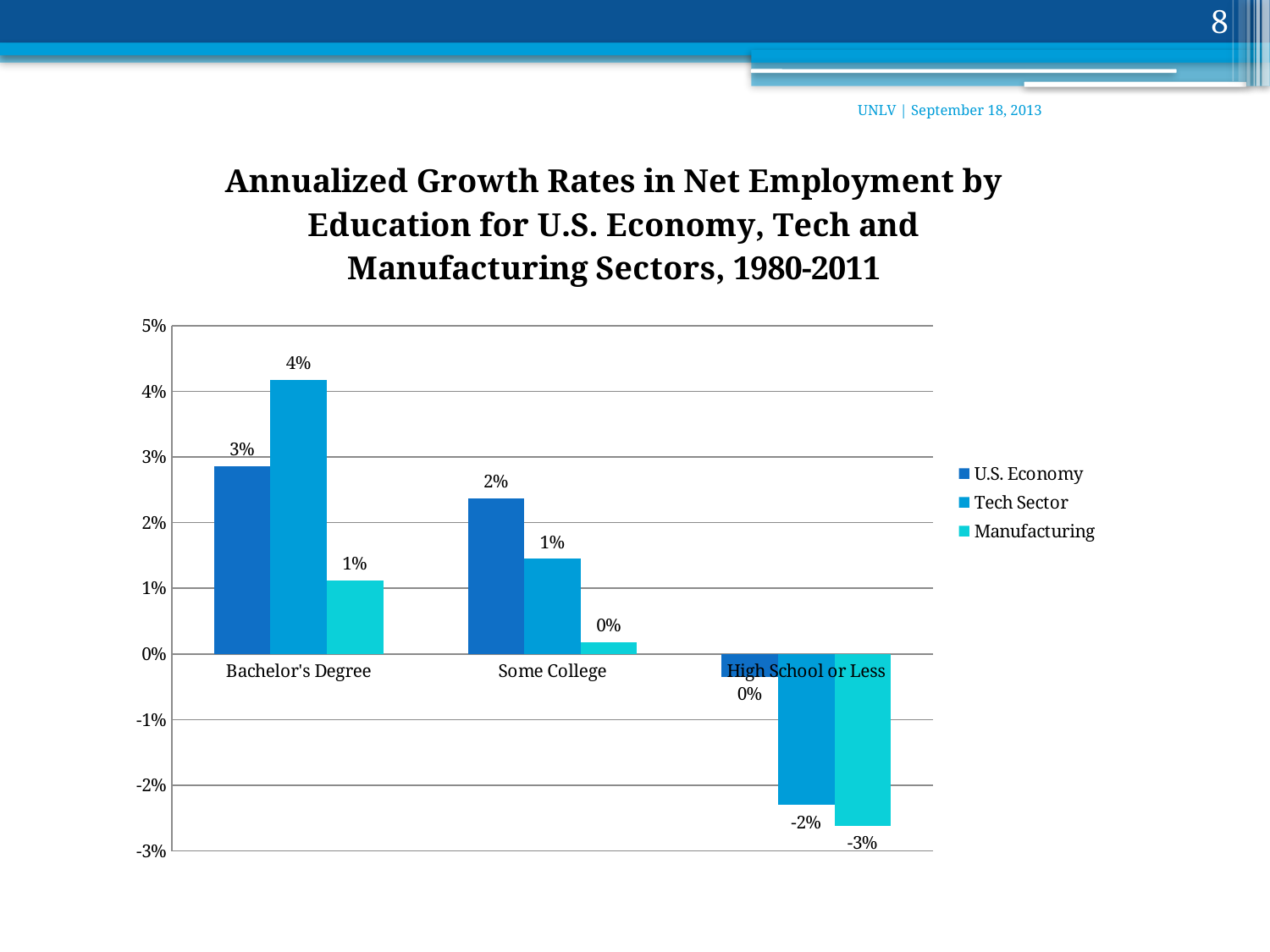
What is the value for Manufacturing in the Some College category? 0% How many series does the legend list? 3 Which series has the lowest value in the High School or Less category? Manufacturing What kind of chart is shown on the slide? Bar chart Is the Tech Sector value for Bachelor's Degree greater or less than 3%? greater Do the Tech Sector values rise or fall moving from Bachelor's Degree to High School or Less? Fall Which series has the highest value in the Bachelor's Degree category? Tech Sector What is the annualized growth rate for the Tech Sector among workers with a Bachelor's Degree? 4% What is the value for Manufacturing in the High School or Less category? -3% How many education categories are shown on the x axis? 3 What is the value for the U.S. Economy in the Some College category? 2% In the Bachelor's Degree category, which is larger: the U.S. Economy bar or the Tech Sector bar? Tech Sector